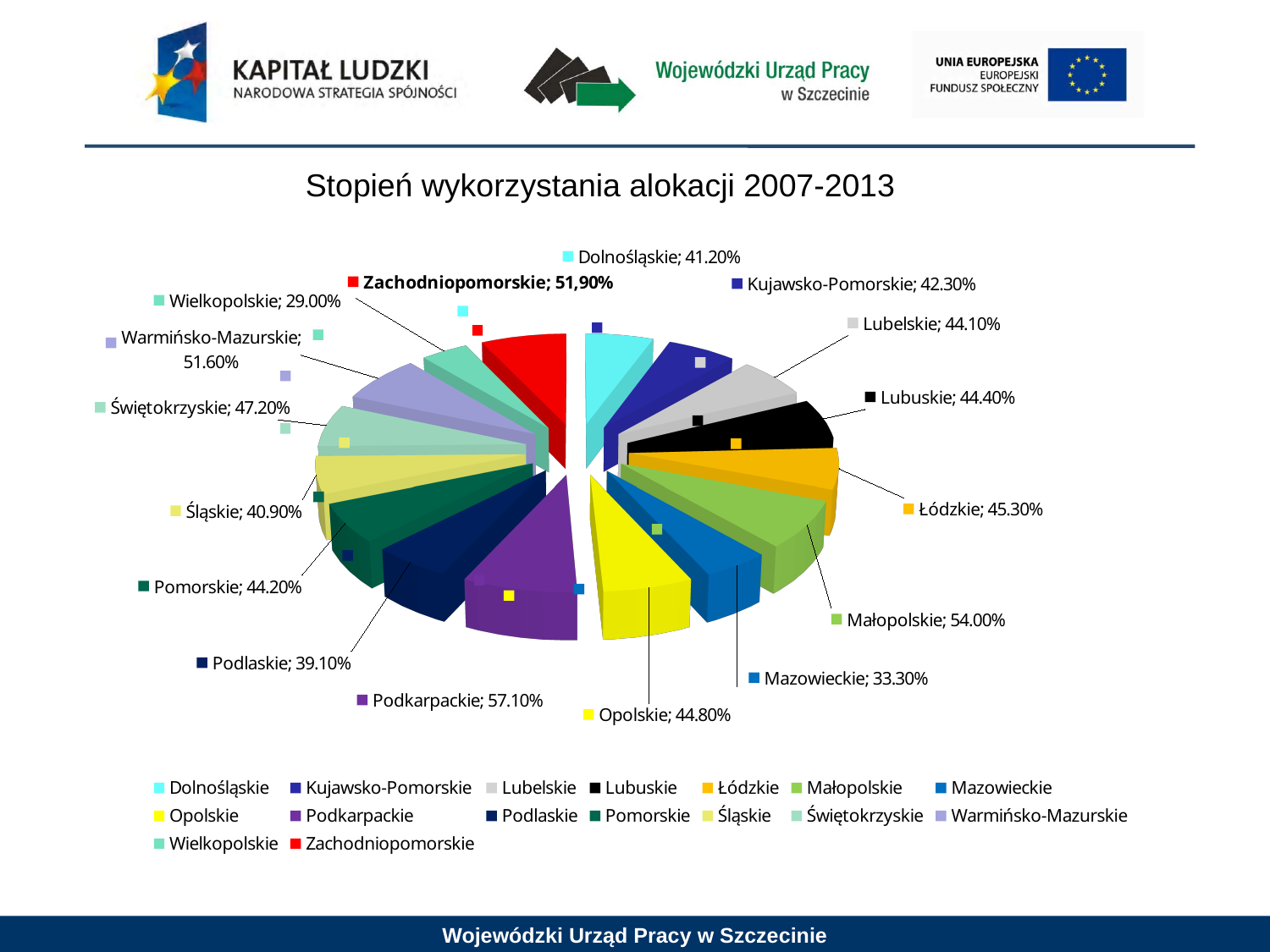
What is the value shown for Zachodniopomorskie? 51,90% How many regions are shown in the chart? 16 What is the difference between the values for Małopolskie and Mazowieckie? 20.70 percentage points Which region has the lowest value in the chart? Wielkopolskie What is the value shown for Świętokrzyskie? 47.20% What is the difference between the values for Podkarpackie and Wielkopolskie? 28.10 percentage points What is the value shown for Małopolskie? 54.00% Which has a larger value, Świętokrzyskie or Śląskie? Świętokrzyskie Which region has the highest value in the chart? Podkarpackie What is the title of the chart? Stopień wykorzystania alokacji 2007-2013 What kind of chart is shown on the slide? Pie chart What is the value shown for Mazowieckie? 33.30%